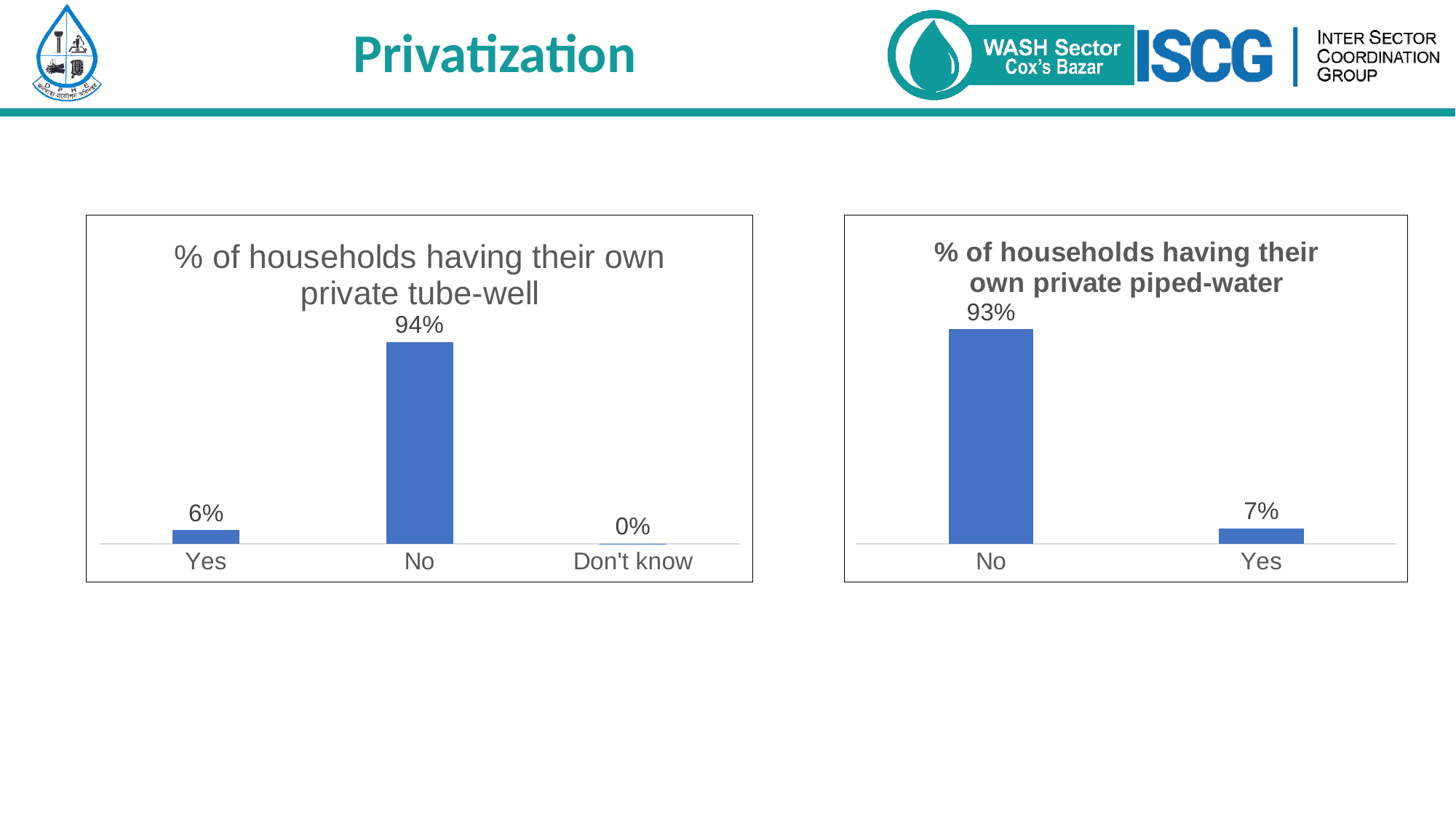
In the chart '% of households having their own private tube-well', which category has the lowest value? Don't know In the chart '% of households having their own private tube-well', what is the value for 'No'? 94% What type of chart is the chart on the right of the slide? Bar chart In the chart '% of households having their own private piped-water', which is larger, 'No' or 'Yes'? No In the chart '% of households having their own private tube-well', what is the value for 'Yes'? 6% In the chart '% of households having their own private piped-water', what is the difference between the values for 'No' and 'Yes'? 86% In the chart '% of households having their own private tube-well', what is the value for 'Don't know'? 0% In the chart '% of households having their own private piped-water', what is the value for 'No'? 93% In the chart '% of households having their own private tube-well', which category has the highest value? No In the chart '% of households having their own private tube-well', what is the difference between the values for 'No' and 'Yes'? 88% How many categories are shown in the chart '% of households having their own private tube-well'? 3 In the chart '% of households having their own private piped-water', what is the value for 'Yes'? 7%